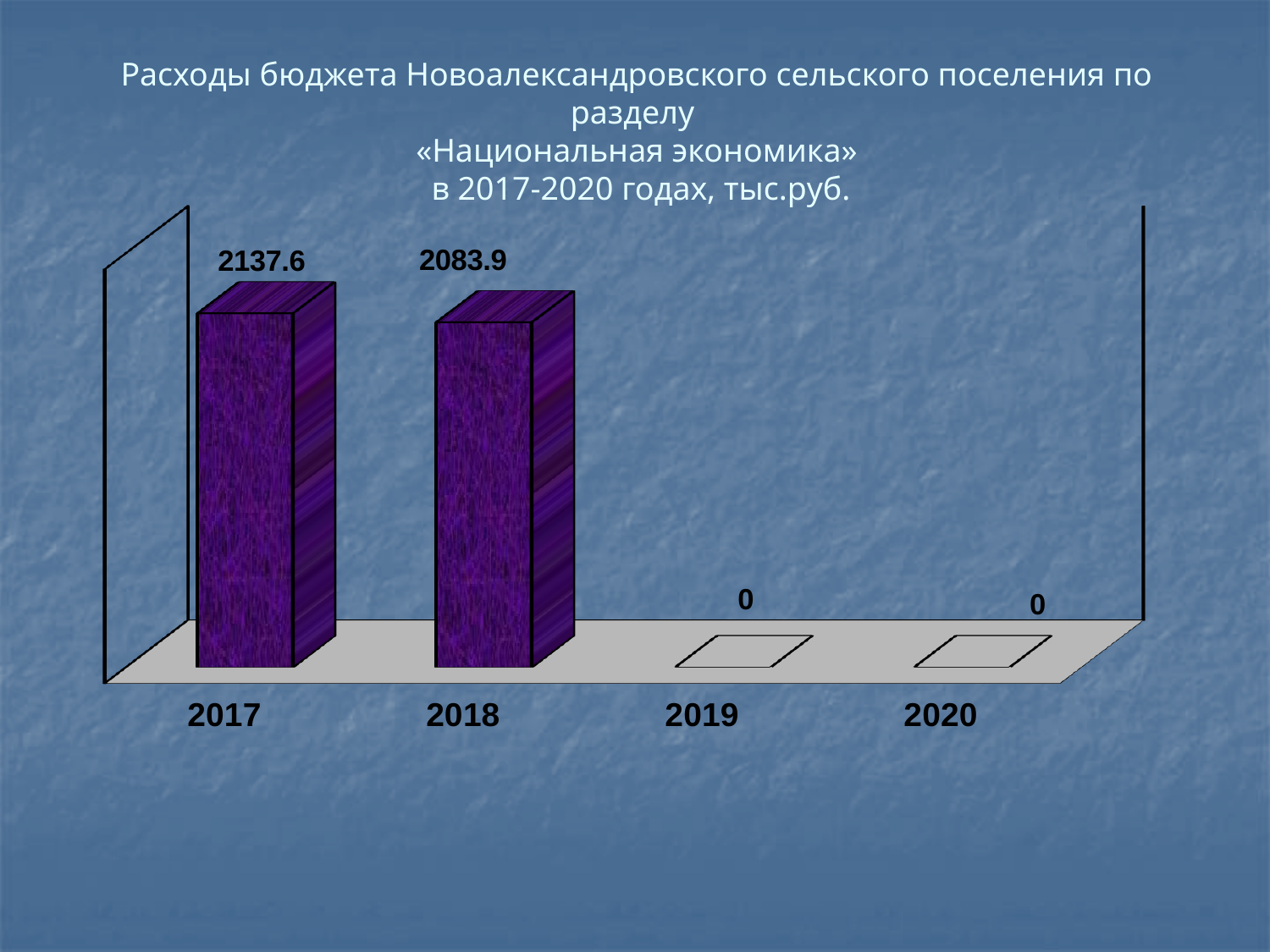
What is the total of the values for 2017 and 2018? 4221.5 How many years are shown on the x axis? 4 What is the value for 2020? 0 What is the difference between the values for 2017 and 2018? 53.7 Which year has the highest value? 2017 What is the value for 2018? 2083.9 In what units are the values in the chart expressed, according to the title? тыс.руб. Do the values rise or fall from 2017 to 2020? fall Which is larger, the value for 2017 or the value for 2018? 2017 What kind of chart is shown on the slide? bar chart What is the value for 2017? 2137.6 What is the value for 2019? 0